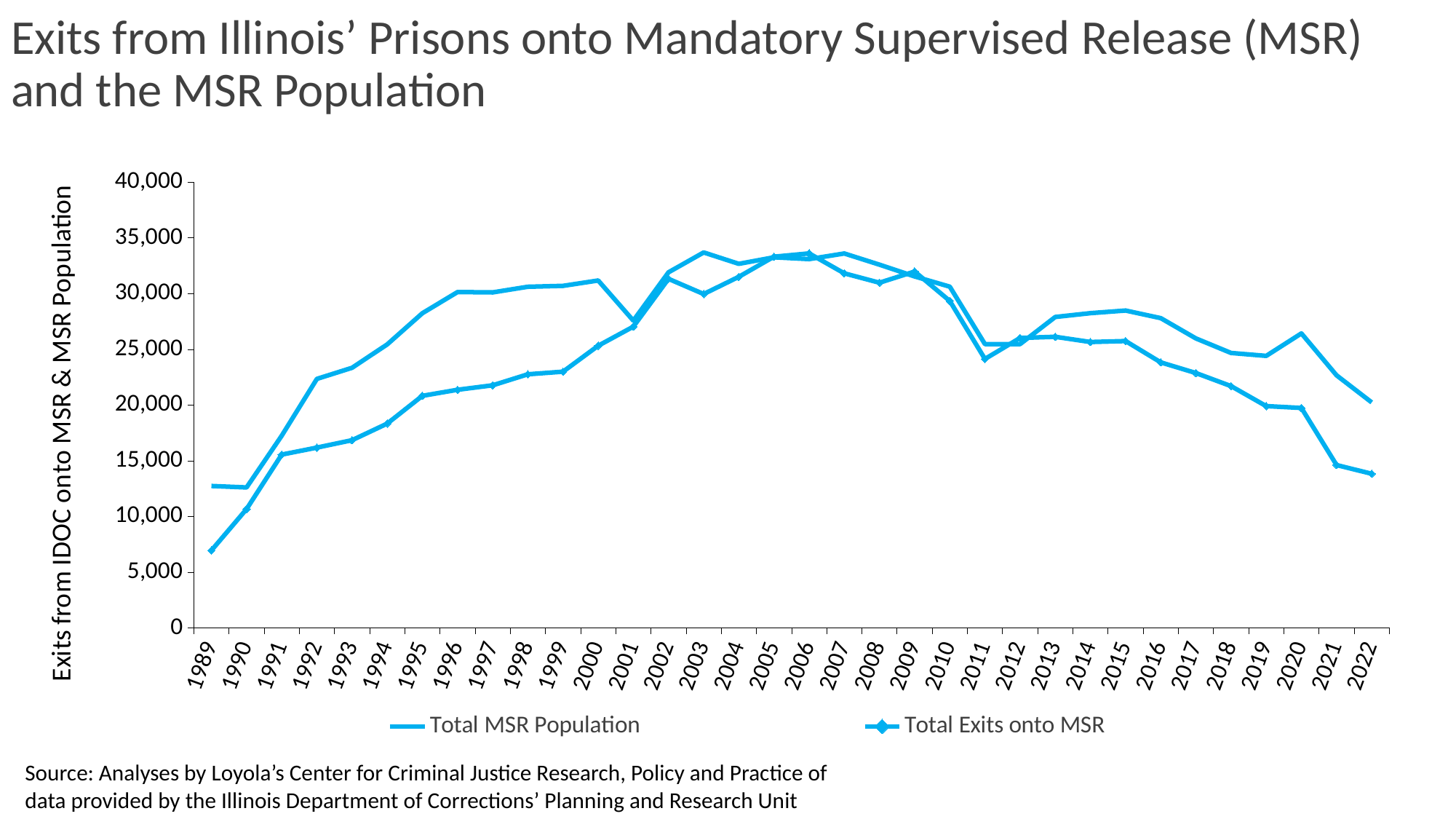
Is the value for Total Exits onto MSR in 1989 greater or less than 10,000? less In which year is Total Exits onto MSR at its lowest? 1989 What kind of chart is shown on the slide? Line chart What is the title of the vertical axis? Exits from IDOC onto MSR & MSR Population Is the value for Total Exits onto MSR in 2022 greater or less than 15,000? less Does Total Exits onto MSR rise or fall from 1989 to 1995? Rise Is the value for Total MSR Population in 2003 greater or less than 30,000? greater In 1989, which series has the higher value, Total MSR Population or Total Exits onto MSR? Total MSR Population How many series does the legend list? 2 In 2022, which series has the higher value, Total MSR Population or Total Exits onto MSR? Total MSR Population How many years are plotted along the x axis? 34